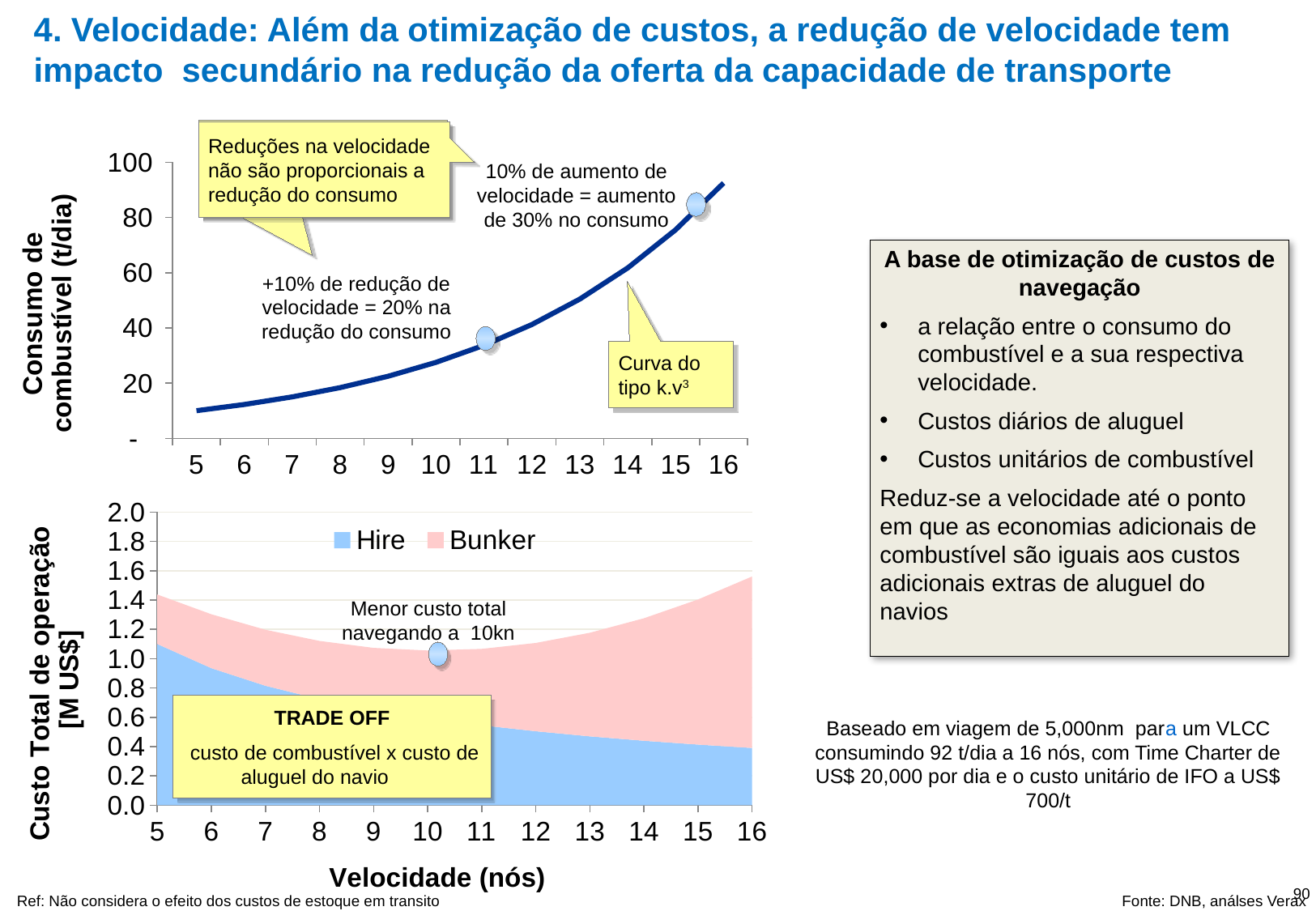
How many series does the legend of the bottom chart list? 2 In the top chart, is the fuel consumption at 16 knots greater or less than 80 t/dia? greater In the top chart, is the fuel consumption at 8 knots greater or less than 40 t/dia? less In the bottom chart, is the Hire value at 16 knots greater or less than 0.6 M US$? less Which two series are listed in the legend of the bottom chart? Hire and Bunker In the bottom chart, does the Hire area rise or fall as speed increases from 5 to 16 knots? fall In the top chart, does fuel consumption rise or fall as speed increases from 5 to 16 knots? rise What kind of chart is the top chart showing fuel consumption (Consumo de combustível) against speed? line chart What is the x-axis title shared by the two charts? Velocidade (nós) What kind of chart is the bottom chart showing total operating cost (Custo Total de operação)? stacked area chart